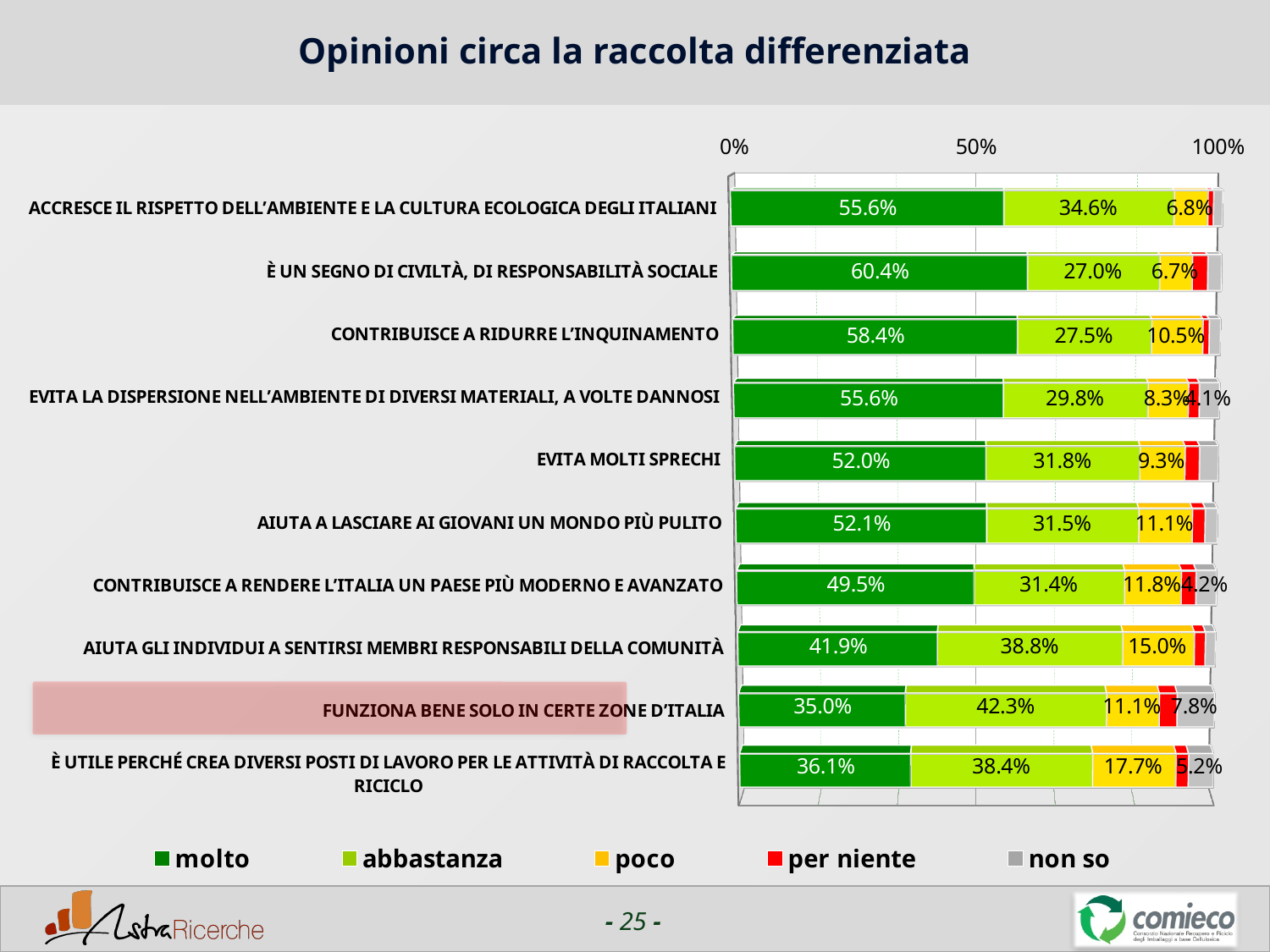
How many statements are shown in the chart? 10 How many response categories does the legend list? 5 What is the difference between the "molto" percentages for "CONTRIBUISCE A RIDURRE L'INQUINAMENTO" and "EVITA MOLTI SPRECHI"? 6.4% What percentage answered "abbastanza" for "FUNZIONA BENE SOLO IN CERTE ZONE D'ITALIA"? 42.3% What percentage answered "molto" for "È UN SEGNO DI CIVILTÀ, DI RESPONSABILITÀ SOCIALE"? 60.4% Which statement has the lowest "molto" percentage? FUNZIONA BENE SOLO IN CERTE ZONE D'ITALIA What percentage answered "poco" for "È UTILE PERCHÉ CREA DIVERSI POSTI DI LAVORO PER LE ATTIVITÀ DI RACCOLTA E RICICLO"? 17.7% Which colour represents "per niente" in the legend? Red Which statement has the highest "molto" percentage? È UN SEGNO DI CIVILTÀ, DI RESPONSABILITÀ SOCIALE What kind of chart is shown on the slide? Stacked bar chart Which is larger: the "abbastanza" percentage for "AIUTA GLI INDIVIDUI A SENTIRSI MEMBRI RESPONSABILI DELLA COMUNITÀ" or for "ACCRESCE IL RISPETTO DELL'AMBIENTE E LA CULTURA ECOLOGICA DEGLI ITALIANI"? AIUTA GLI INDIVIDUI A SENTIRSI MEMBRI RESPONSABILI DELLA COMUNITÀ Which statement has the highest "poco" percentage? È UTILE PERCHÉ CREA DIVERSI POSTI DI LAVORO PER LE ATTIVITÀ DI RACCOLTA E RICICLO